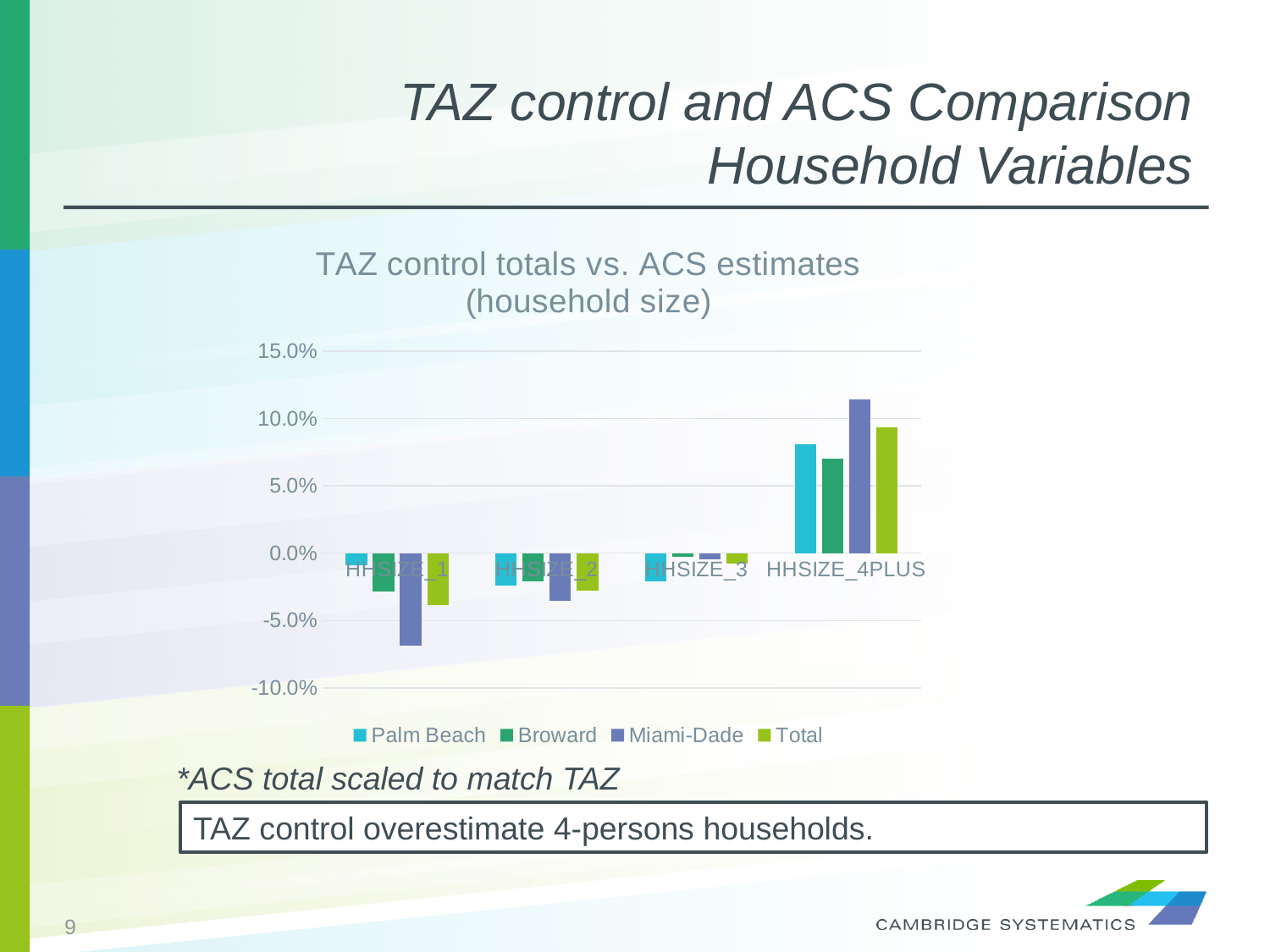
For HHSIZE_4PLUS, which is larger: the Broward value or the Miami-Dade value? Miami-Dade Is the Palm Beach value for HHSIZE_4PLUS greater or less than 5.0%? greater Is the Miami-Dade value for HHSIZE_1 greater or less than -5.0%? less Which category has the lowest (most negative) bar in the chart? HHSIZE_1 What is the title of the chart? TAZ control totals vs. ACS estimates (household size) Is the Miami-Dade value for HHSIZE_4PLUS greater or less than 10.0%? greater How many household size categories are shown on the x axis? 4 Which series has the highest value for HHSIZE_4PLUS? Miami-Dade Which series has the lowest value for HHSIZE_1? Miami-Dade What kind of chart is shown on the slide? bar chart How many series does the legend list? 4 Which category is the only one where all four series have positive values? HHSIZE_4PLUS